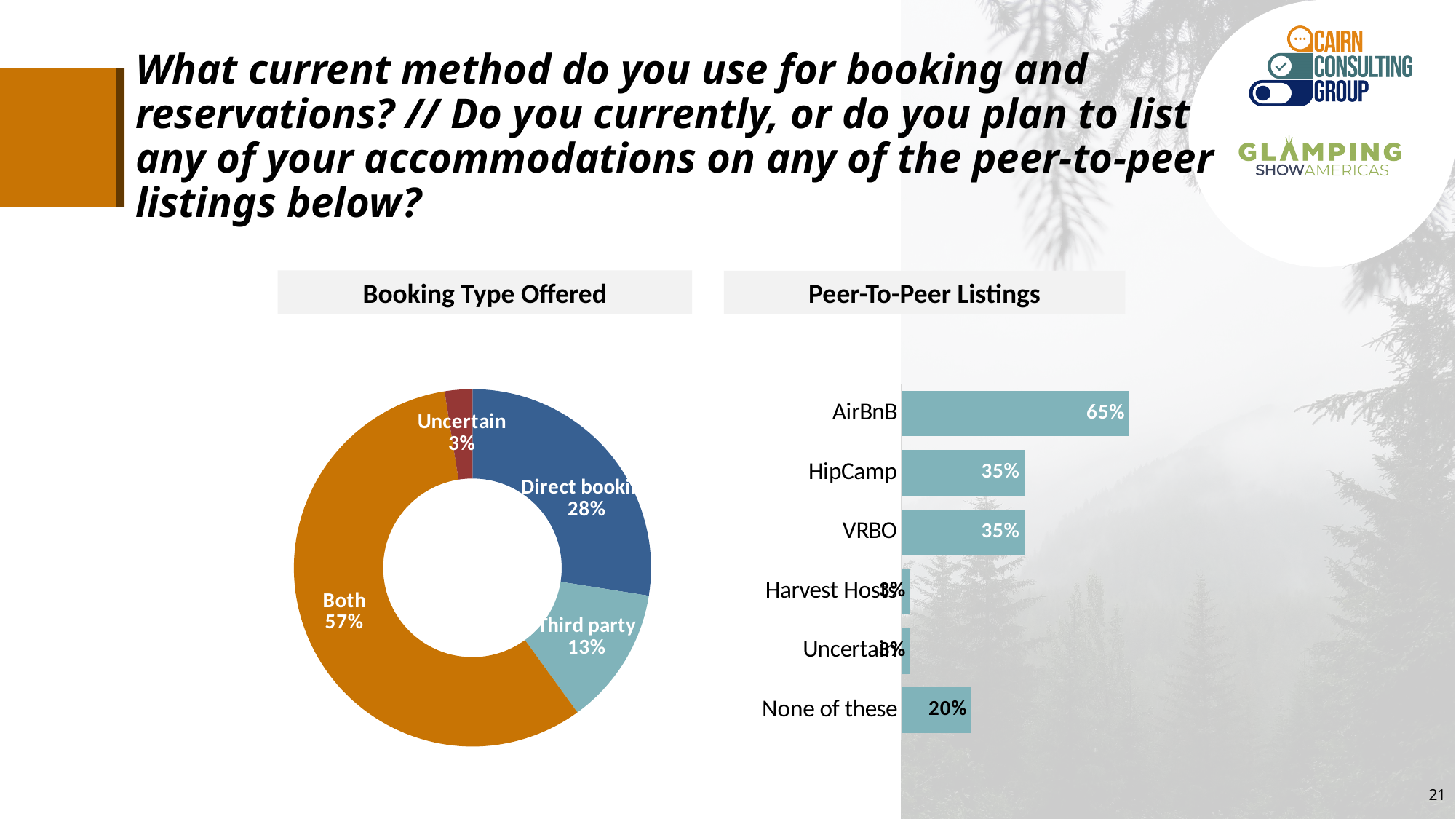
What kind of chart is the Peer-To-Peer Listings chart? Bar chart How many categories are shown in the Booking Type Offered chart? 4 In the Booking Type Offered chart, what is the difference between the Both and Third party shares? 44% In the Booking Type Offered chart, which category has the smallest share? Uncertain In the Peer-To-Peer Listings chart, which listing has the highest value? AirBnB In the Peer-To-Peer Listings chart, what is the value for AirBnB? 65% In the Booking Type Offered chart, what share of respondents use both booking methods? 57% What kind of chart is the Booking Type Offered chart? Donut (pie) chart In the Booking Type Offered chart, what percentage is shown for Direct booking? 28% In the Peer-To-Peer Listings chart, which is larger: VRBO or None of these? VRBO In the Peer-To-Peer Listings chart, what is the difference between AirBnB and HipCamp? 30% In the Peer-To-Peer Listings chart, what is the value for None of these? 20%